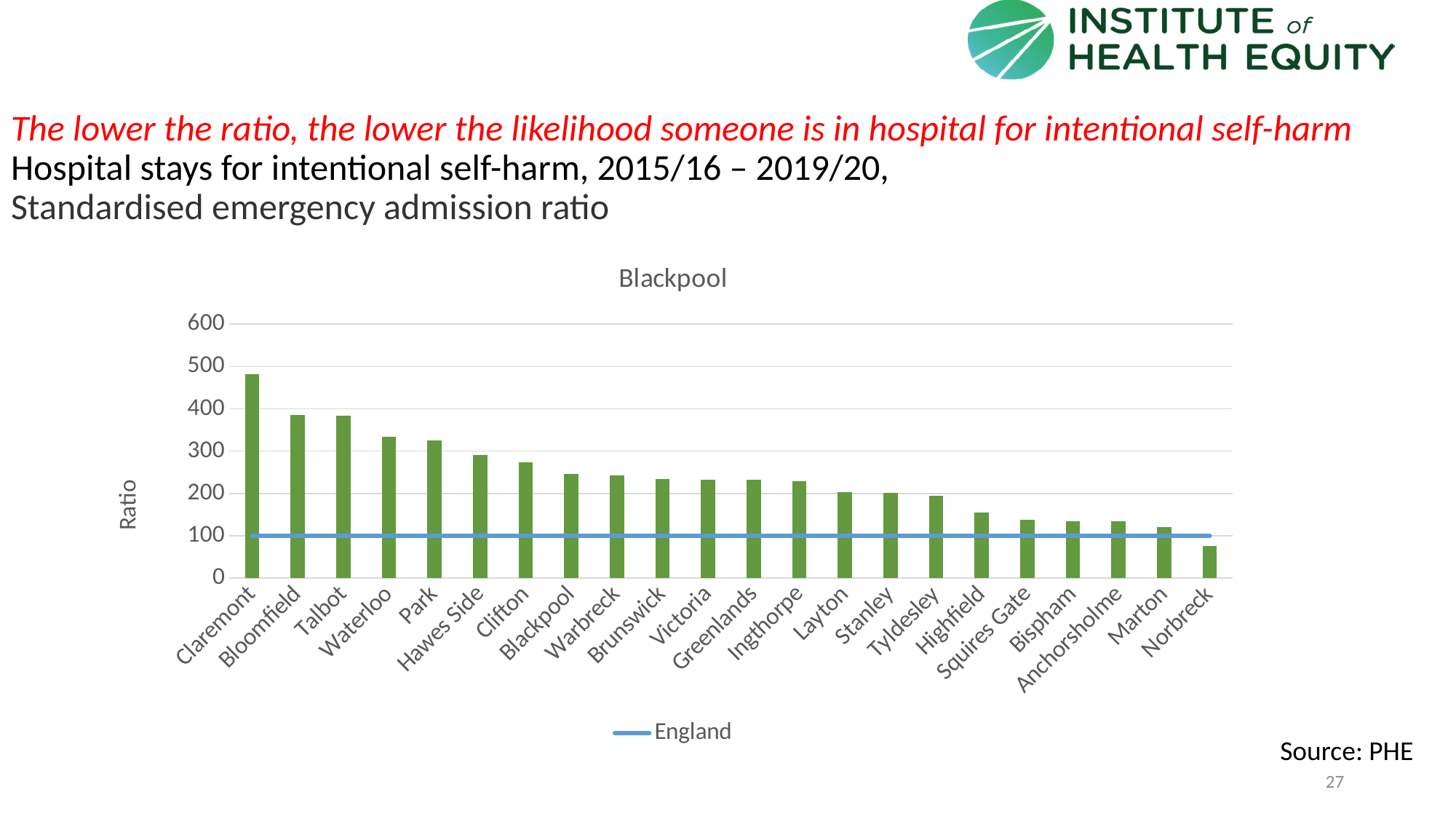
Which area has the highest standardised emergency admission ratio? Claremont How many areas (bars) are plotted in the Blackpool chart? 22 Do the bar values rise or fall from left to right along the x axis? fall Is the value for Norbreck greater or less than 100? less Which has the larger ratio, Claremont or Bloomfield? Claremont Which area has the lowest standardised emergency admission ratio? Norbreck Is the value for Waterloo greater or less than 300? greater Is the value for Highfield greater or less than 200? less Which has the larger ratio, Layton or Squires Gate? Layton What kind of chart is shown on the slide? bar chart What is the value of the England reference line shown on the chart? 100